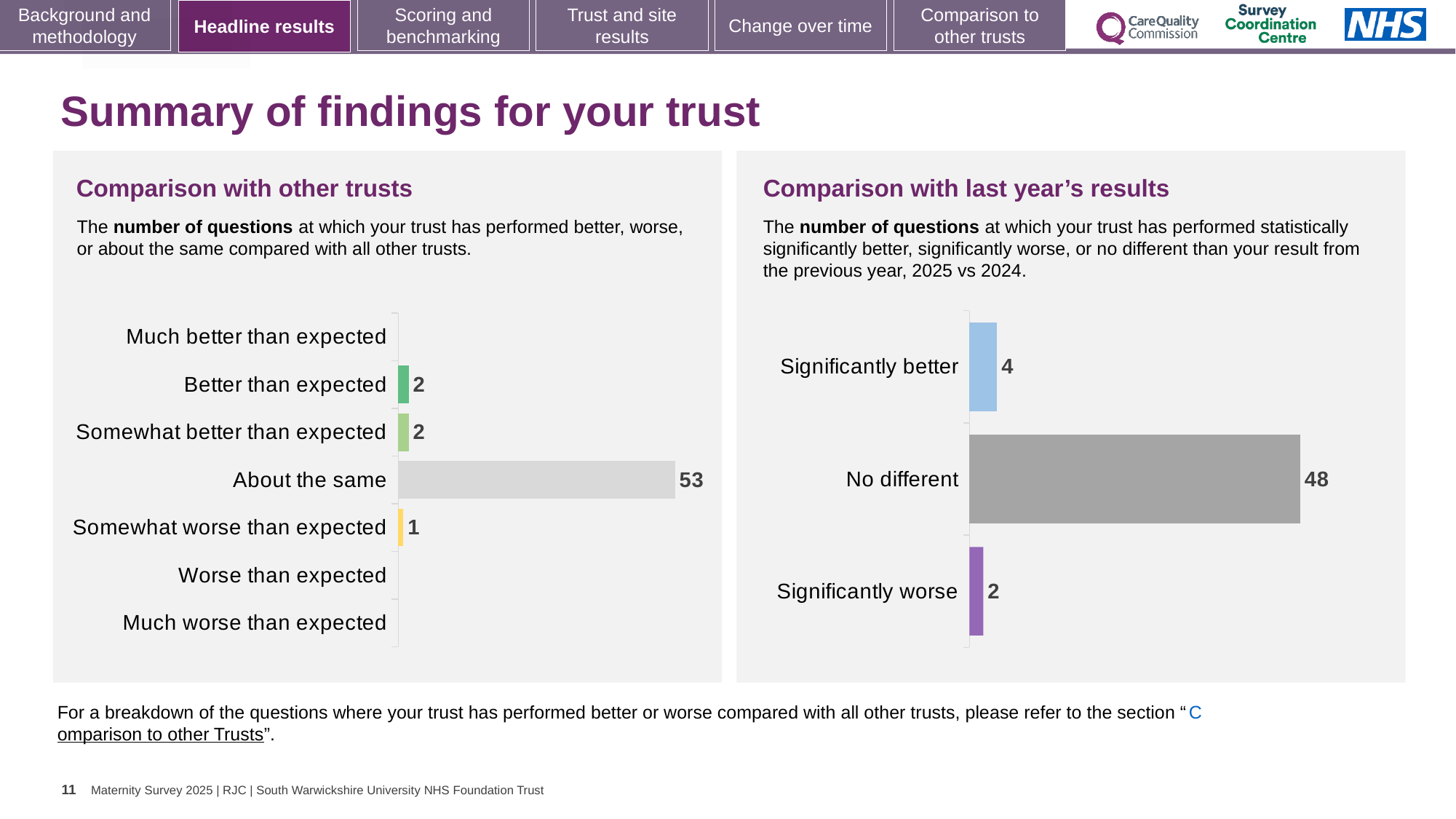
In the 'Comparison with other trusts' chart, what is the value for 'Somewhat worse than expected'? 1 In the 'Comparison with last year's results' chart, which category has the lowest value? Significantly worse In the 'Comparison with other trusts' chart, how many categories are listed on the axis? 7 In the 'Comparison with other trusts' chart, what is the difference between 'About the same' and 'Better than expected'? 51 In the 'Comparison with last year's results' chart, what is the value for 'Significantly better'? 4 In the 'Comparison with other trusts' chart, is the value for 'Better than expected' larger than the value for 'Somewhat worse than expected'? Yes In the 'Comparison with last year's results' chart, what is the difference between 'Significantly better' and 'Significantly worse'? 2 What type of chart is used in the 'Comparison with last year's results' panel? Bar chart In the 'Comparison with other trusts' chart, which category has the highest value? About the same In the 'Comparison with last year's results' chart, what is the total of the three categories? 54 In the 'Comparison with last year's results' chart, what is the value for 'No different'? 48 In the 'Comparison with other trusts' chart, what is the value for 'About the same'? 53